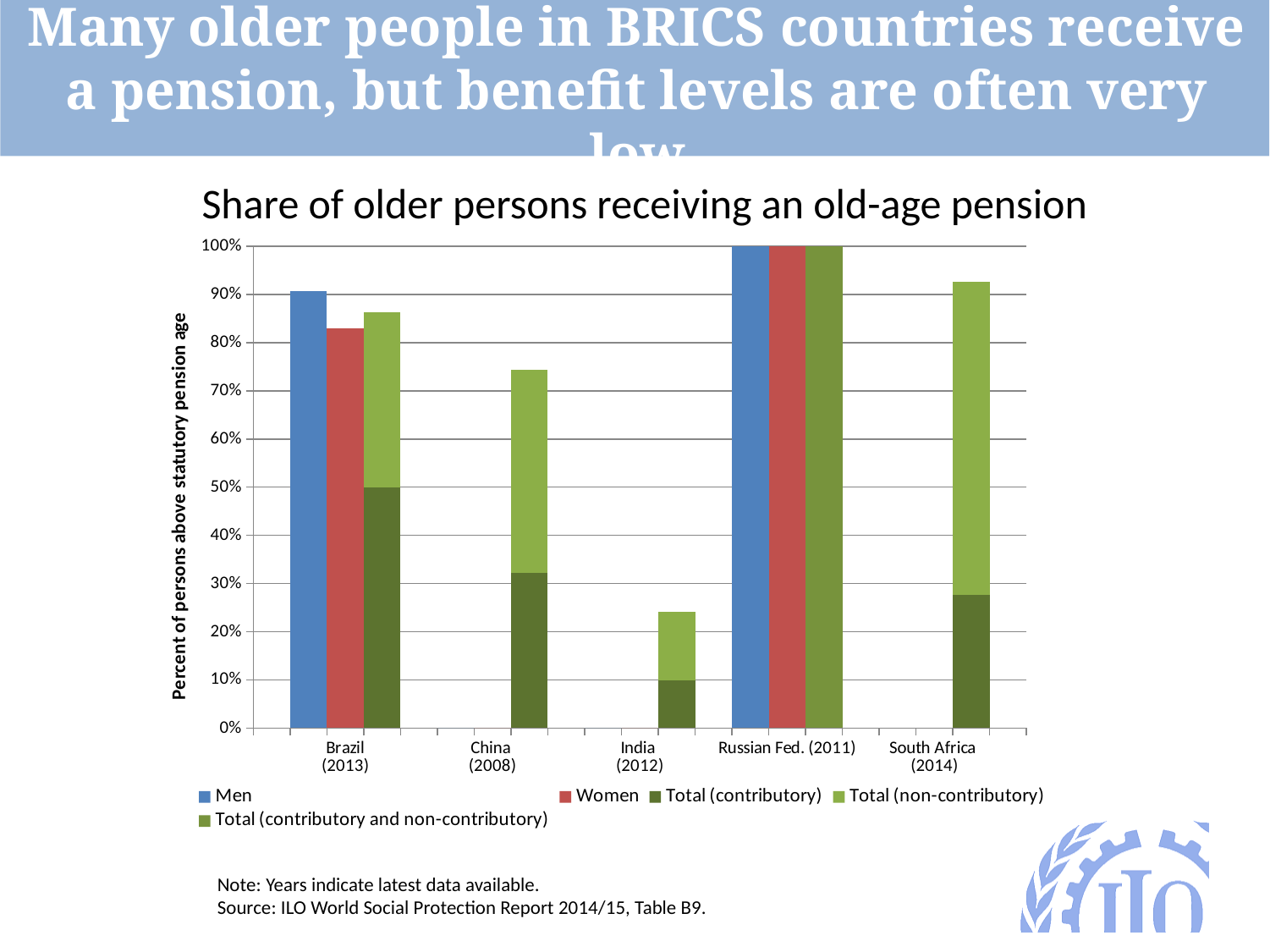
How many countries are shown on the x axis of the chart? 5 In Brazil (2013), which is larger, the value for Men or the value for Women? Men Is the total (contributory and non-contributory) value for India (2012) greater or less than 30%? less What is the title of the chart? Share of older persons receiving an old-age pension How many series does the chart's legend list? 5 What type of chart is shown on the slide? bar chart What is the value for Men in the Russian Fed. (2011)? 100% Is the value for Women in Brazil (2013) greater or less than 80%? greater Is the total (contributory and non-contributory) value for South Africa (2014) greater or less than 90%? greater Which country has the lowest total share of older persons receiving an old-age pension? India (2012) What is the value for Women in the Russian Fed. (2011)? 100% Which country has the highest share of older persons receiving an old-age pension? Russian Fed. (2011)